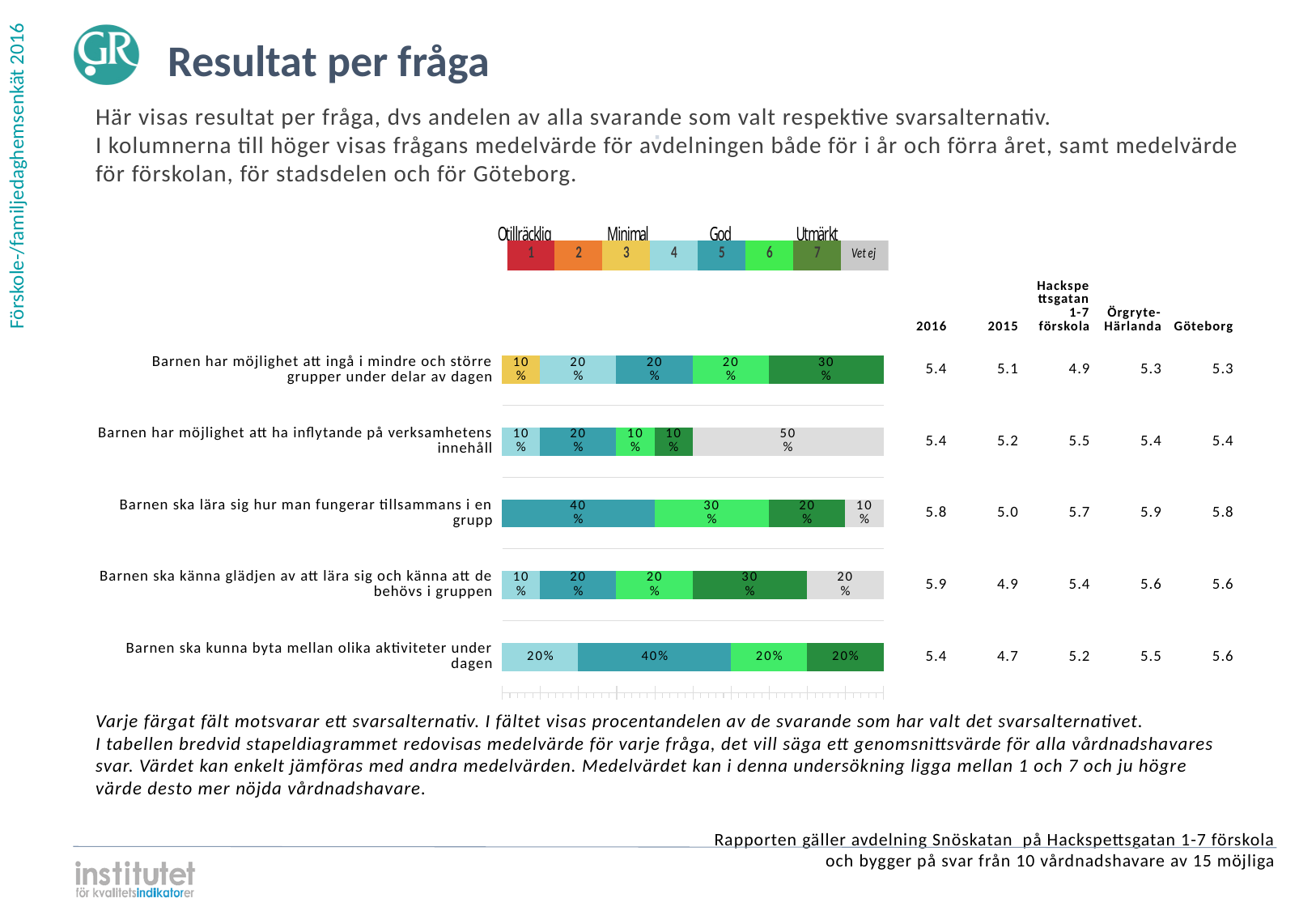
What percentage of respondents chose 'Vet ej' for 'Barnen har möjlighet att ha inflytande på verksamhetens innehåll'? 50% What percentage chose answer 7 (dark green) for 'Barnen har möjlighet att ingå i mindre och större grupper under delar av dagen'? 30% Which question has the largest 'Vet ej' share? Barnen har möjlighet att ha inflytande på verksamhetens innehåll What kind of chart is shown on the slide? Stacked bar chart What is the 2015 mean value for 'Barnen ska kunna byta mellan olika aktiviteter under dagen'? 4.7 For 'Barnen ska lära sig hur man fungerar tillsammans i en grupp', what is the difference between the share choosing 5 and the share choosing 7? 20% Which question has the highest 2016 mean value? Barnen ska känna glädjen av att lära sig och känna att de behövs i gruppen What percentage chose answer 5 (teal) for 'Barnen ska kunna byta mellan olika aktiviteter under dagen'? 40% What is the 2016 mean value for 'Barnen ska känna glädjen av att lära sig och känna att de behövs i gruppen'? 5.9 Which answer alternative in the legend is labelled 'Utmärkt'? 7 For 'Barnen ska känna glädjen av att lära sig och känna att de behövs i gruppen', which is larger: the share choosing 7 or the share choosing 'Vet ej'? 7 How many questions (bars) are shown in the chart? 5